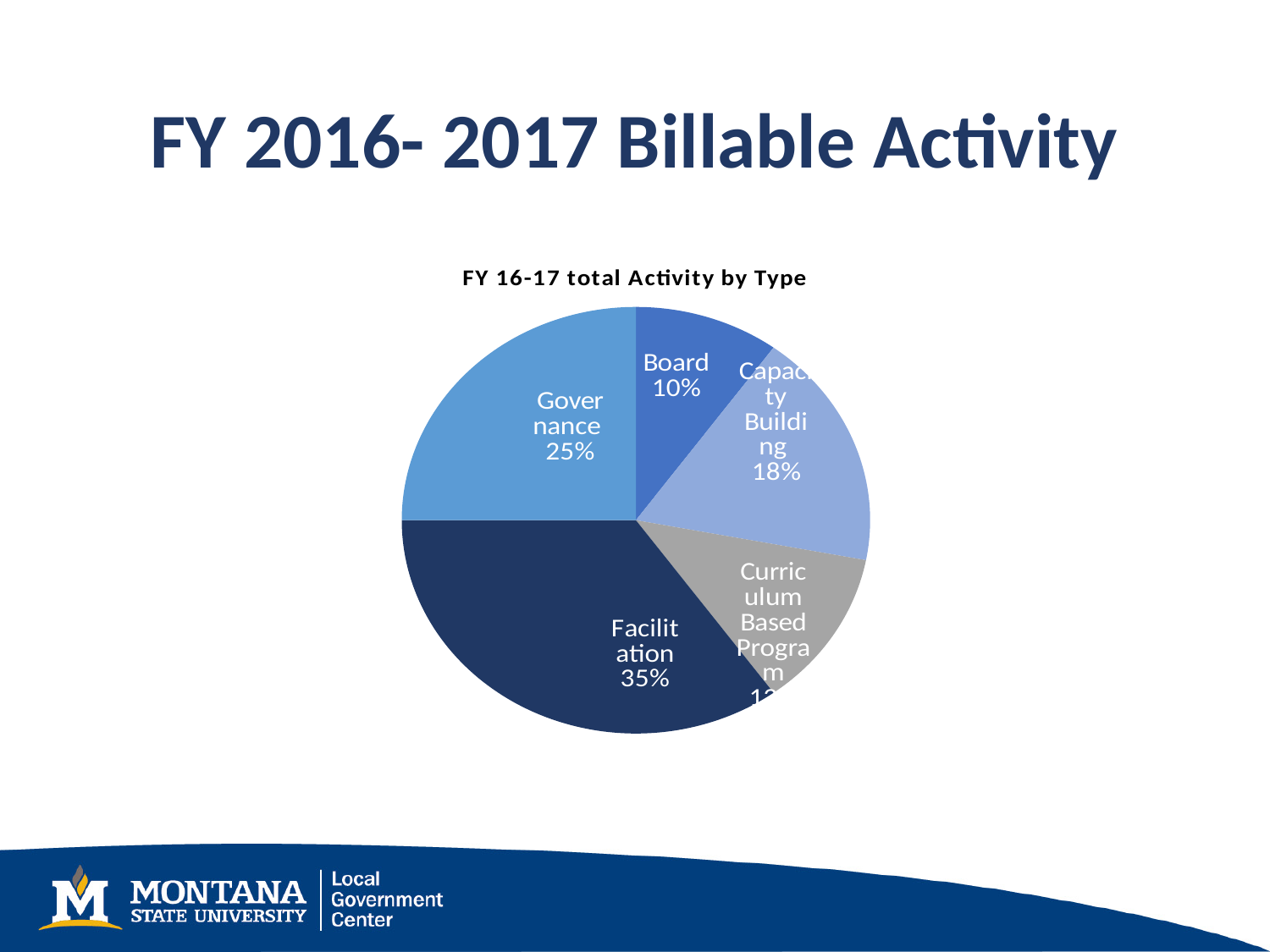
What kind of chart is shown on the slide? pie chart What percentage of activity is Board? 10% What percentage of activity is Facilitation? 35% What percentage of activity is Governance? 25% What is the title of the chart? FY 16-17 total Activity by Type How many percentage points larger is Governance than Board? 15 How many slices does the pie chart have? 5 How many percentage points larger is Facilitation than Governance? 10 What share of the pie does the Facilitation slice represent? 35% What percentage of activity is Capacity Building? 18% Which is larger, the share for Governance or the share for Capacity Building? Governance Which activity type has the largest share of the pie? Facilitation